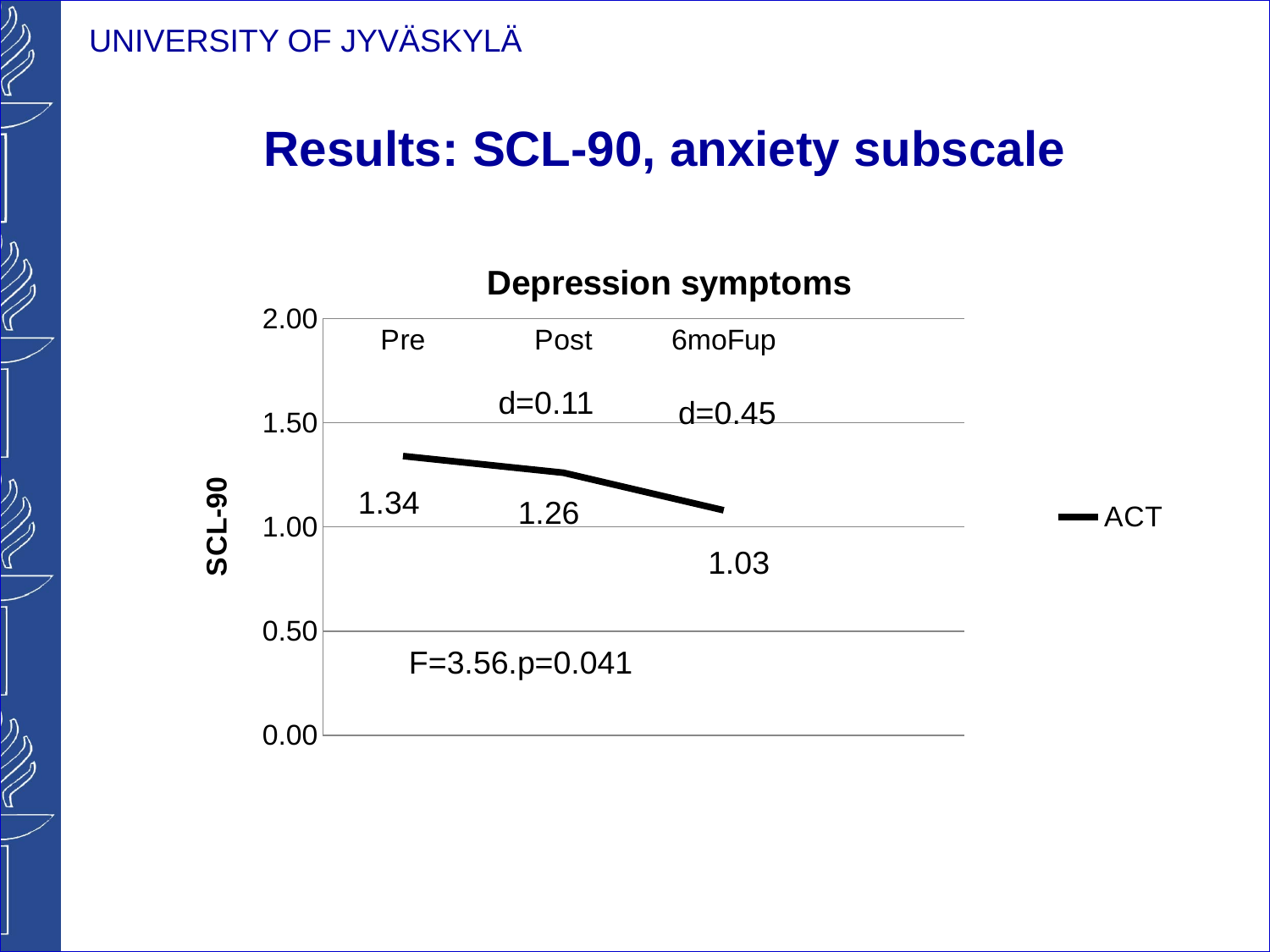
What is the difference between the ACT value at Pre and at Post? 0.08 What is the value for ACT at Post? 1.26 Is the ACT value at 6moFup greater or less than 1.50? less At which time point is the ACT value lowest? 6moFup At which time point is the ACT value highest? Pre What is the difference between the ACT value at Pre and at 6moFup? 0.31 How many time points are plotted on the x axis? 3 What is the value for ACT at 6moFup? 1.03 What is the value for ACT at Pre? 1.34 How many series does the legend list? 1 Which is larger, the ACT value at Post or at 6moFup? Post What kind of chart is shown? line chart